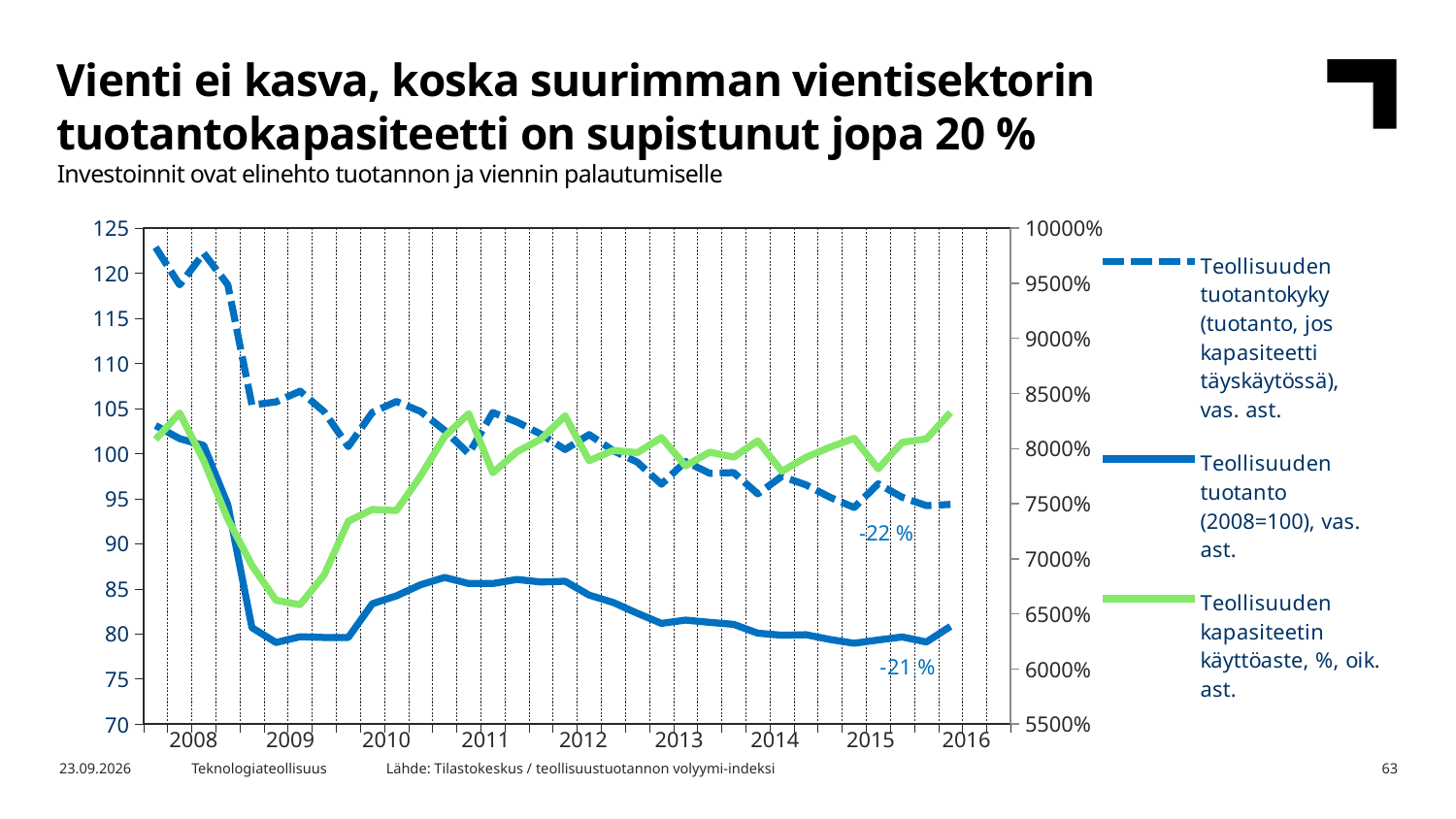
What kind of chart is shown on the slide? line chart Is the value of Teollisuuden tuotanto at the end of the series in 2016 greater or less than 85? less How many year labels are shown on the x axis? 9 Which series is drawn with a dashed line? Teollisuuden tuotantokyky (tuotanto, jos kapasiteetti täyskäytössä), vas. ast. At the end of the series in 2016, which is higher on the left axis: Teollisuuden tuotantokyky or Teollisuuden tuotanto? Teollisuuden tuotantokyky Does Teollisuuden tuotanto rise or fall overall from 2008 to 2016? fall Is the value of Teollisuuden tuotantokyky at the end of the series in 2016 greater or less than 100? less Does Teollisuuden tuotantokyky rise or fall overall from 2008 to 2016? fall Which series is plotted on the right-hand axis (oik. ast.)? Teollisuuden kapasiteetin käyttöaste, %, oik. ast. Is the value of Teollisuuden tuotantokyky at the start of 2008 greater or less than 120? greater How many series does the legend list? 3 What is the highest value shown on the left-hand axis? 125